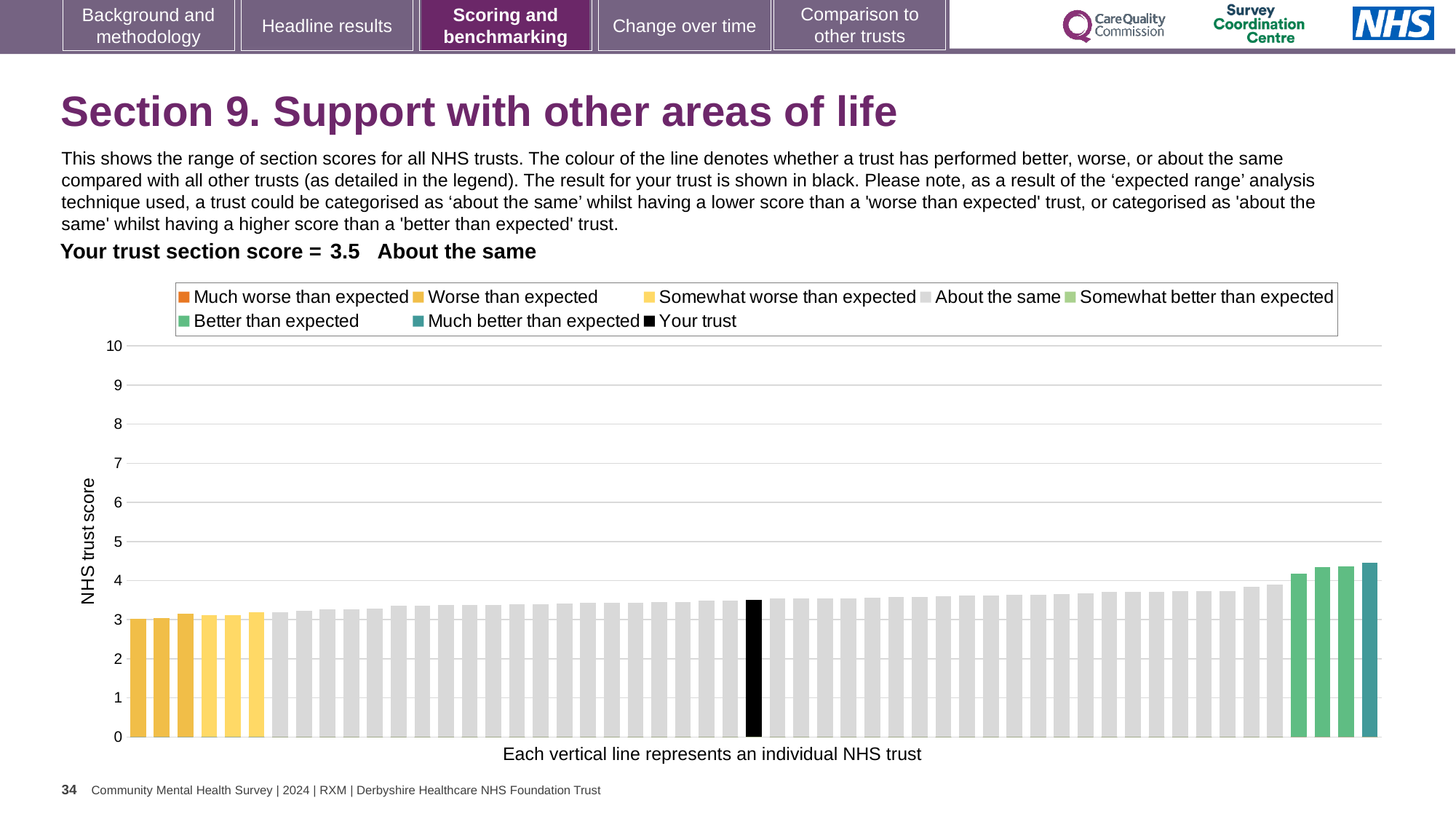
What colour is the bar representing your trust? black What is the label on the vertical axis of the chart? NHS trust score How many entries does the chart legend list? 8 Is the value of the shortest bar (the leftmost trust) greater or less than 2? greater Do the bar values rise or fall from left to right along the x axis? rise What is the section score for your trust? 3.5 What is the highest value shown on the vertical axis? 10 What kind of chart is shown on the slide? bar chart Is the value for your trust (the black bar) greater or less than 4? less Which performance category is your trust placed in for this section? About the same Is the value for your trust (the black bar) greater or less than 3? greater